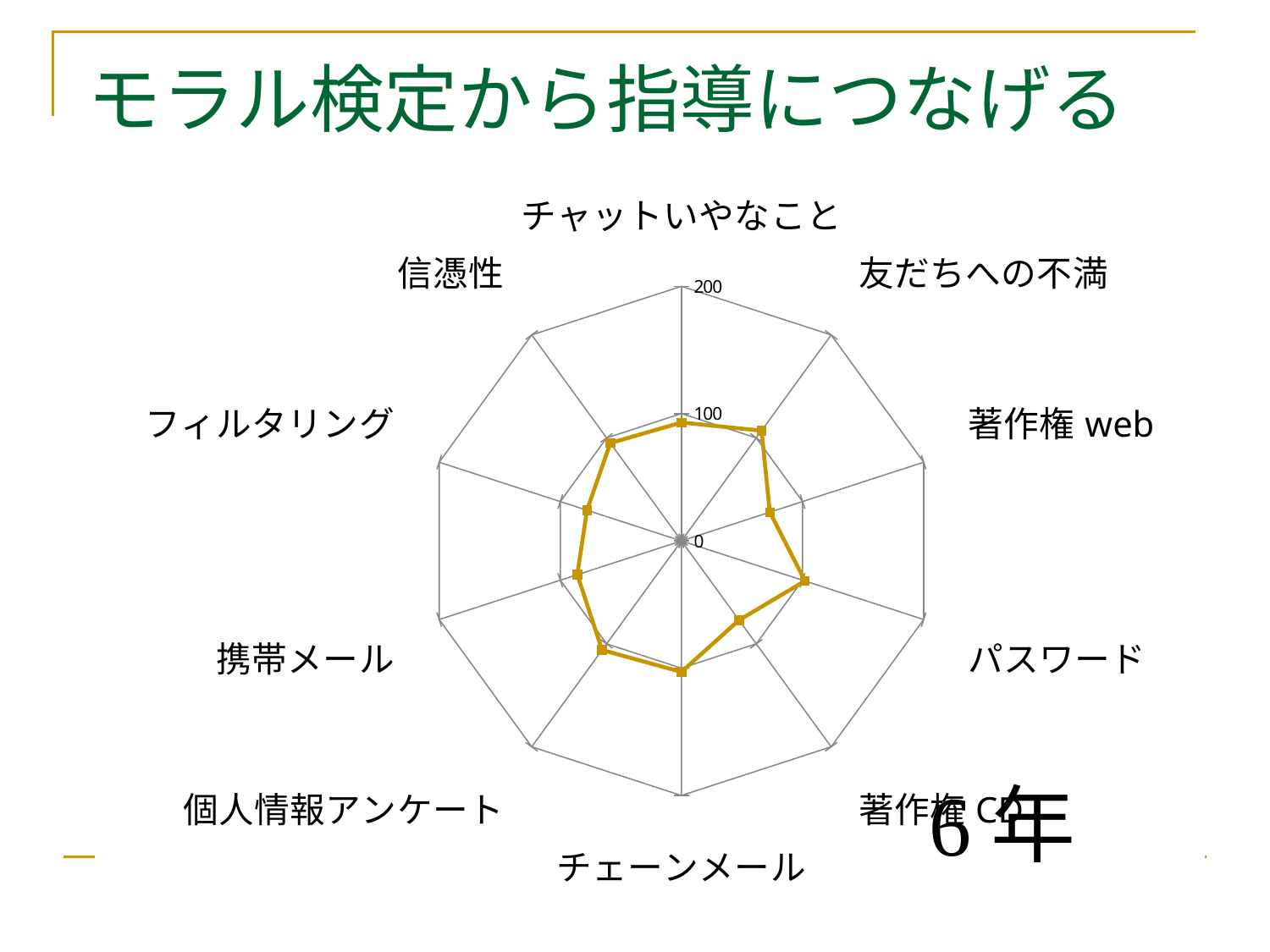
Which has the larger value, 個人情報アンケート or 著作権 CD? 個人情報アンケート Which has the larger value, チェーンメール or フィルタリング? チェーンメール Is the value for 著作権 CD greater or less than 100? less Is the value for 著作権 web greater or less than 100? less What is the title of the slide containing the radar chart? モラル検定から指導につなげる Which has the larger value, パスワード or 著作権 web? パスワード Is the value for チェーンメール greater or less than 200? less What kind of chart is shown on the slide? radar chart How many categories (axes) does the radar chart have? 10 What is the maximum value shown on the radar chart's axis scale? 200